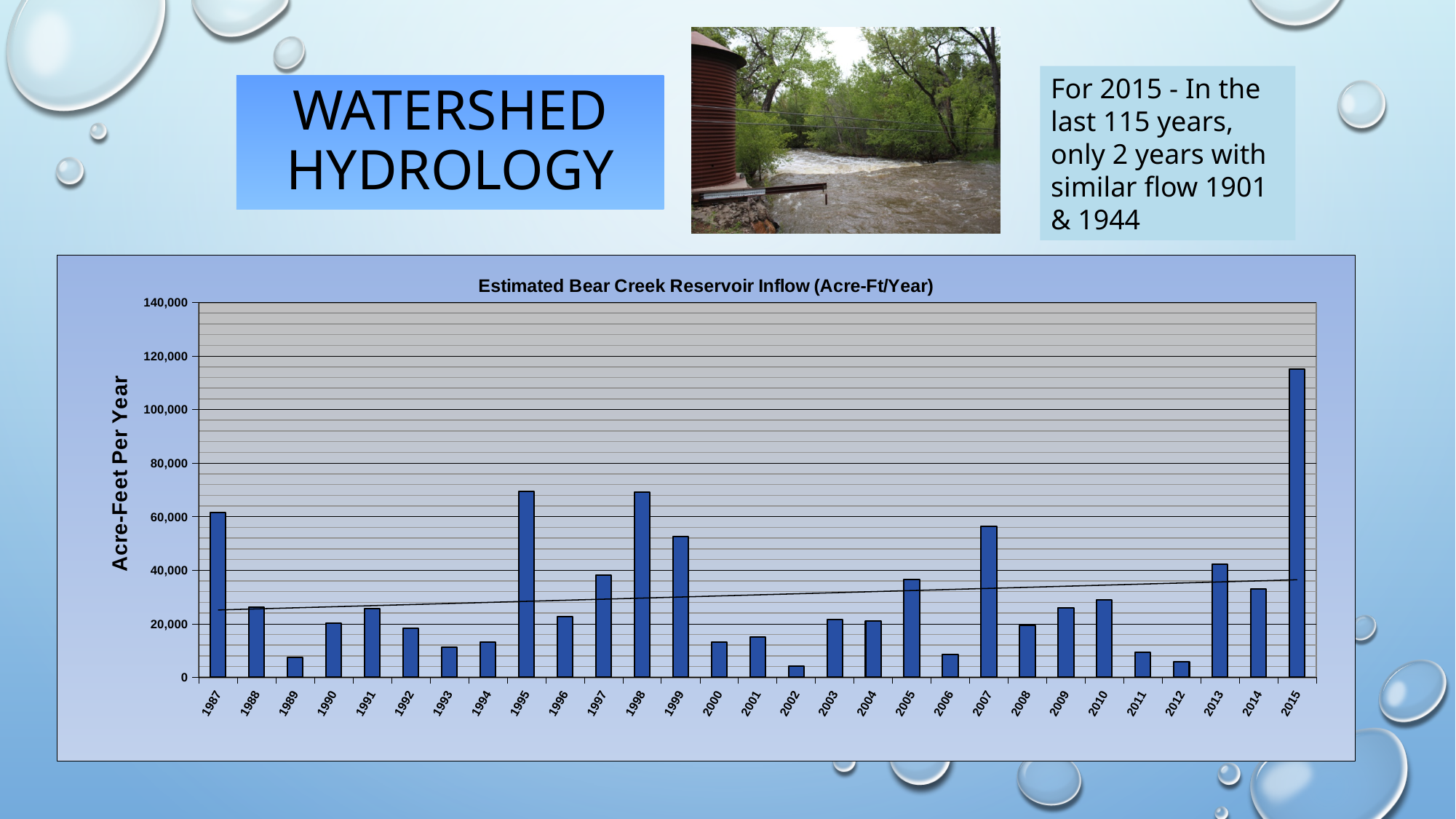
Is the value for 1989 greater or less than 20,000? less Which year has the larger inflow, 1999 or 1997? 1999 Is the value for 2015 greater or less than 100,000? greater Which year has the highest estimated inflow in the chart? 2015 How many years are plotted on the chart? 29 Which year has the larger inflow, 1987 or 1988? 1987 Is the value for 2007 greater or less than 40,000? greater What kind of chart is shown on the slide? bar chart What is the label on the vertical axis of the chart? Acre-Feet Per Year What is the title of the chart? Estimated Bear Creek Reservoir Inflow (Acre-Ft/Year)